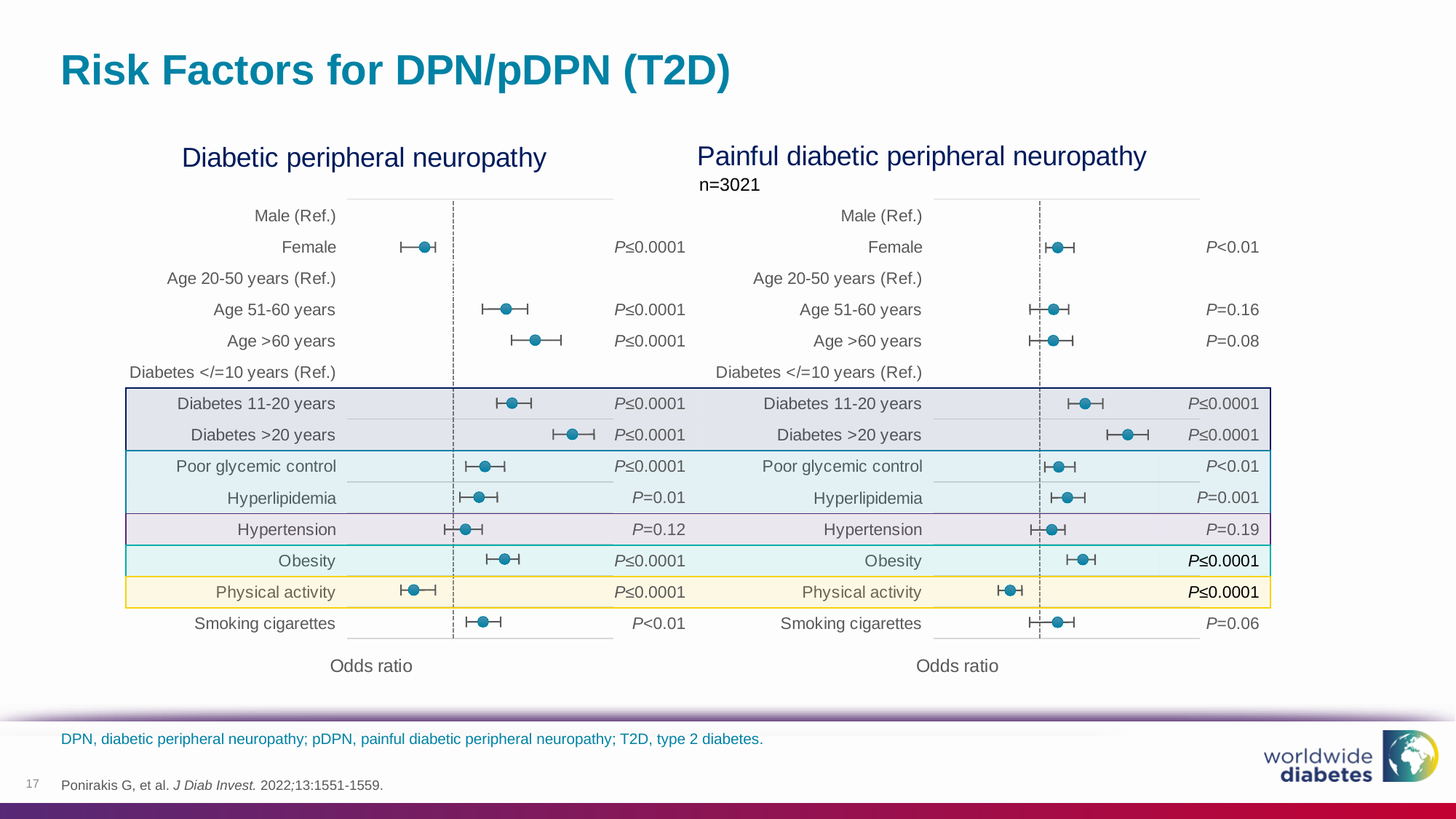
In the Diabetic peripheral neuropathy chart, what is the P value shown for Hypertension? P=0.12 In the Painful diabetic peripheral neuropathy chart, which has the larger odds ratio: Diabetes 11-20 years or Diabetes >20 years? Diabetes >20 years In the Diabetic peripheral neuropathy chart, what is the P value shown for Hyperlipidemia? P=0.01 What kind of chart is used to show the risk factors on this slide? Forest plot What sample size is stated for the Painful diabetic peripheral neuropathy chart? n=3021 In the Painful diabetic peripheral neuropathy chart, which risk factor has the lowest odds ratio? Physical activity In the Painful diabetic peripheral neuropathy chart, what is the P value shown for Hyperlipidemia? P=0.001 How many risk factors have a plotted odds ratio point in the Diabetic peripheral neuropathy chart? 11 In the Diabetic peripheral neuropathy chart, which has the larger odds ratio: Age 51-60 years or Age >60 years? Age >60 years In the Painful diabetic peripheral neuropathy chart, what is the P value shown for Smoking cigarettes? P=0.06 In the Painful diabetic peripheral neuropathy chart, what is the P value shown for Age 51-60 years? P=0.16 In the Diabetic peripheral neuropathy chart, which risk factor has the highest odds ratio? Diabetes >20 years